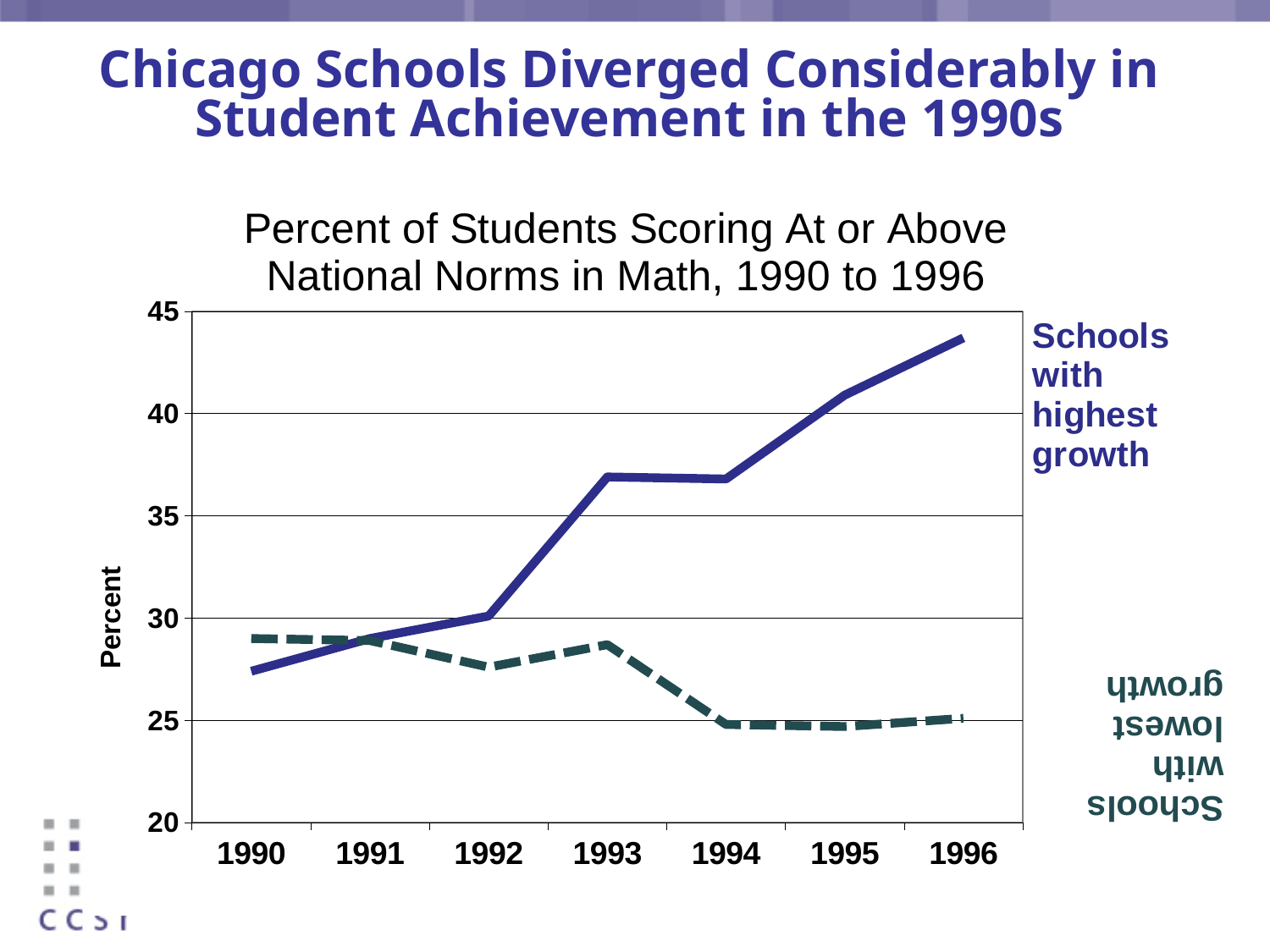
How many years are plotted along the x axis? 7 In which year is the value for Schools with highest growth the highest? 1996 What is the label on the y axis of the chart? Percent In which year is the value for Schools with highest growth the lowest? 1990 Does the line for Schools with highest growth rise or fall from 1990 to 1996? rise Is the value for Schools with highest growth in 1996 greater or less than 40? greater Is the value for Schools with highest growth in 1990 greater or less than 30? less Is the value for Schools with lowest growth in 1994 greater or less than 30? less What kind of chart is shown on the slide? line chart How many lines (series) are plotted on the chart? 2 In 1996, which series has the larger value: Schools with highest growth or Schools with lowest growth? Schools with highest growth